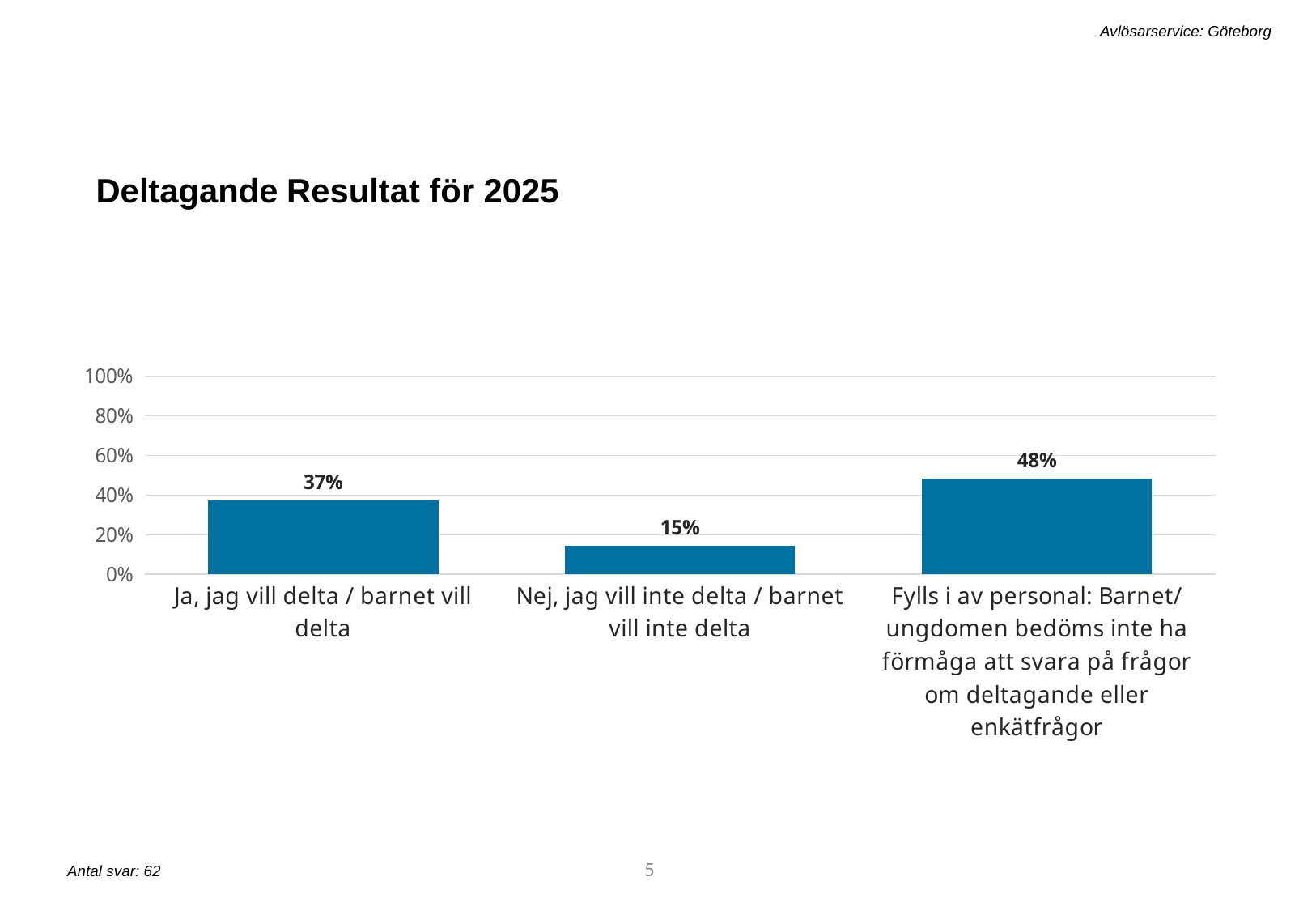
What is the difference between the "Fylls i av personal" value and the "Ja, jag vill delta" value? 11% What is the value for "Nej, jag vill inte delta / barnet vill inte delta"? 15% What kind of chart is shown on the slide? Bar chart Which is larger: the value for "Ja, jag vill delta" or the value for "Nej, jag vill inte delta"? Ja, jag vill delta / barnet vill delta What is the value for "Ja, jag vill delta / barnet vill delta"? 37% What is the difference between the "Ja, jag vill delta" value and the "Nej, jag vill inte delta" value? 22% Which category has the highest value? Fylls i av personal: Barnet/ungdomen bedöms inte ha förmåga att svara på frågor om deltagande eller enkätfrågor Which category has the lowest value? Nej, jag vill inte delta / barnet vill inte delta What is the title of the slide? Deltagande Resultat för 2025 What is the value for the category "Fylls i av personal"? 48% How many categories are shown in the chart? 3 Is the value for "Fylls i av personal" greater or less than 40%? greater